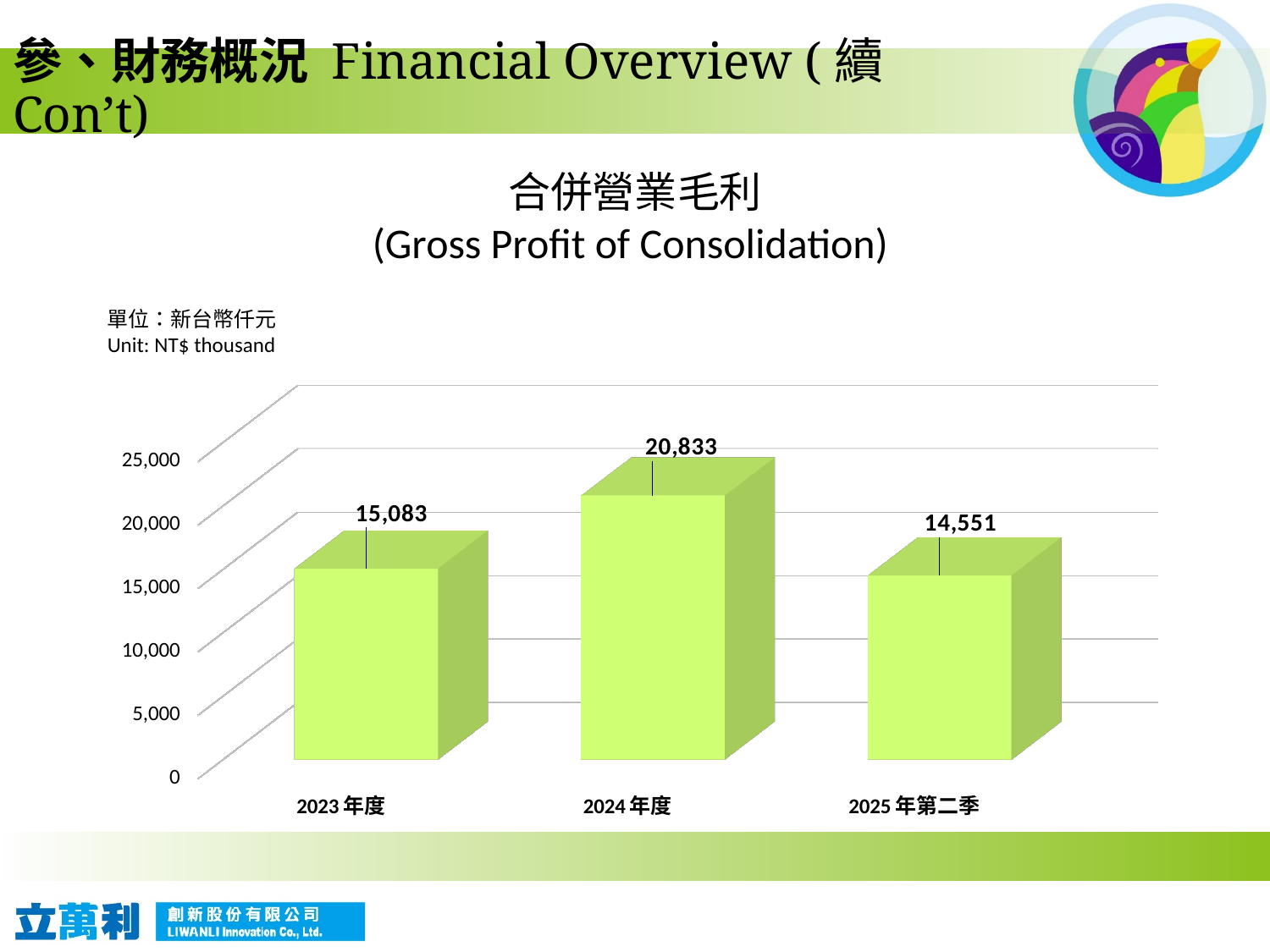
What is the gross profit value for 2023年度? 15,083 What is the difference between the gross profit for 2023年度 and 2025年第二季? 532 What is the gross profit value for 2025年第二季? 14,551 Is the value for 2024年度 greater or less than 20,000? greater What is the gross profit value for 2024年度? 20,833 What kind of chart is shown on the slide? bar chart Which category has the lowest gross profit? 2025年第二季 What is the difference between the gross profit for 2024年度 and 2023年度? 5,750 How many categories are shown on the chart? 3 Which category has the highest gross profit? 2024年度 Which is larger, the gross profit for 2024年度 or for 2025年第二季? 2024年度 What unit is the chart's data expressed in? NT$ thousand